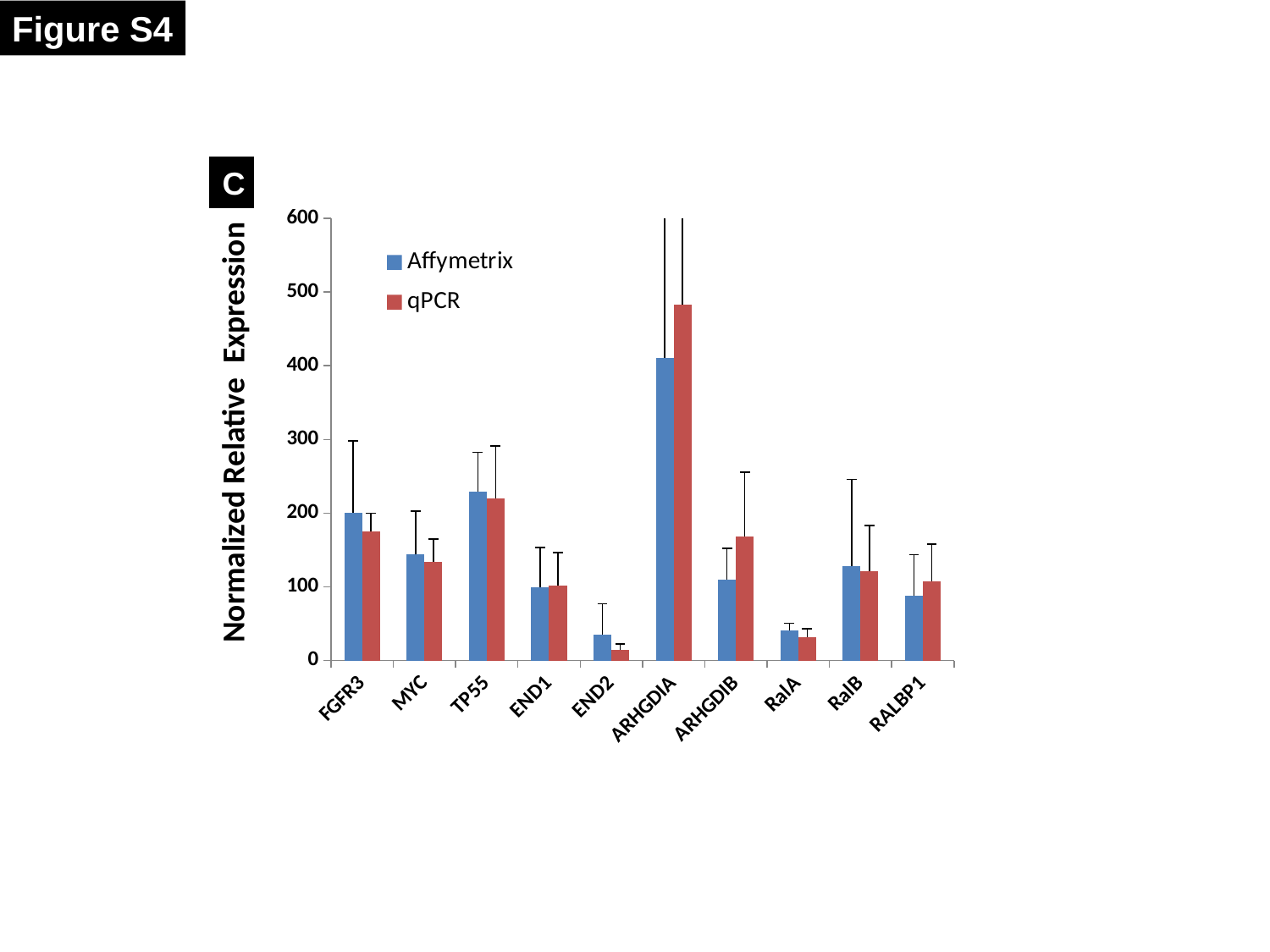
For ARHGDIB, which is larger: the Affymetrix value or the qPCR value? qPCR What is the label of the y axis? Normalized Relative Expression Which gene has the highest qPCR value? ARHGDIA For END2, which is larger: the Affymetrix value or the qPCR value? Affymetrix Is the qPCR value for ARHGDIA greater or less than 400? greater Is the Affymetrix value for TP55 greater or less than 200? greater Is the Affymetrix value for RalA greater or less than 100? less Which gene has the lowest qPCR value? END2 How many gene categories are shown on the x axis? 10 What kind of chart is shown on the slide? bar chart How many series does the legend list? 2 Which gene has the highest Affymetrix value? ARHGDIA